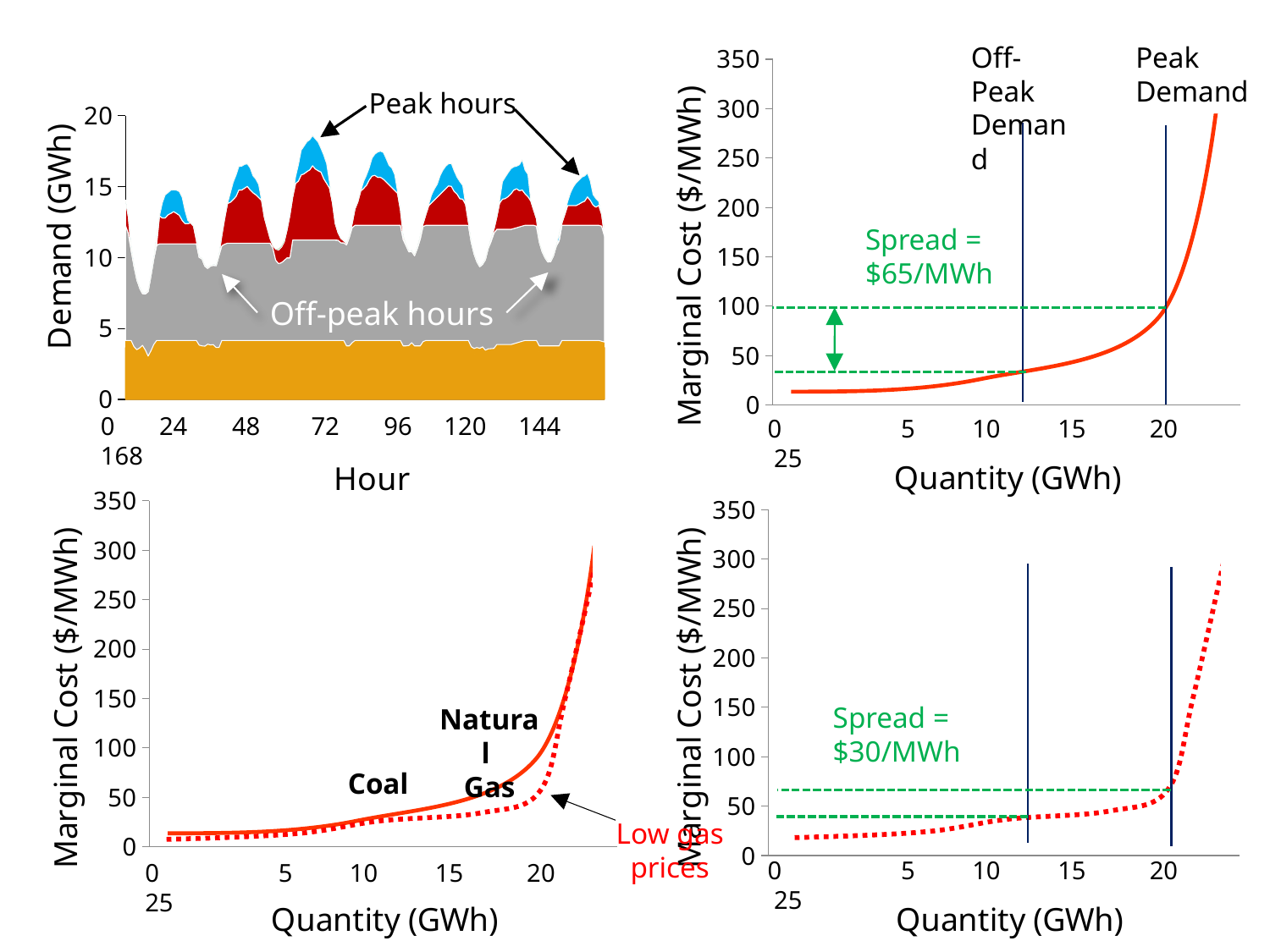
In the top-right marginal cost chart, what spread value is annotated between off-peak and peak demand? $65/MWh In the bottom-right marginal cost chart, what spread value is annotated? $30/MWh In the top-right marginal cost chart, does marginal cost rise or fall as quantity increases? Rises In the top-right marginal cost chart, is the marginal cost at the Peak Demand line greater or less than 50 $/MWh? greater Which chart shows the larger annotated spread, the top-right chart or the bottom-right chart? Top-right chart What kind of chart is the top-left chart showing Demand (GWh) against Hour? Area chart In the top-left demand chart, is the highest peak demand greater or less than 20 GWh? less In the top-left demand chart, what is the label of the x axis? Hour In the bottom-left marginal cost chart, which line is lower at a quantity of 20 GWh, the solid line or the dotted 'Low gas prices' line? The dotted 'Low gas prices' line In the top-right marginal cost chart, is the marginal cost at the Off-Peak Demand line greater or less than 50 $/MWh? less What is the difference between the spread annotated in the top-right chart and the spread annotated in the bottom-right chart? $35/MWh